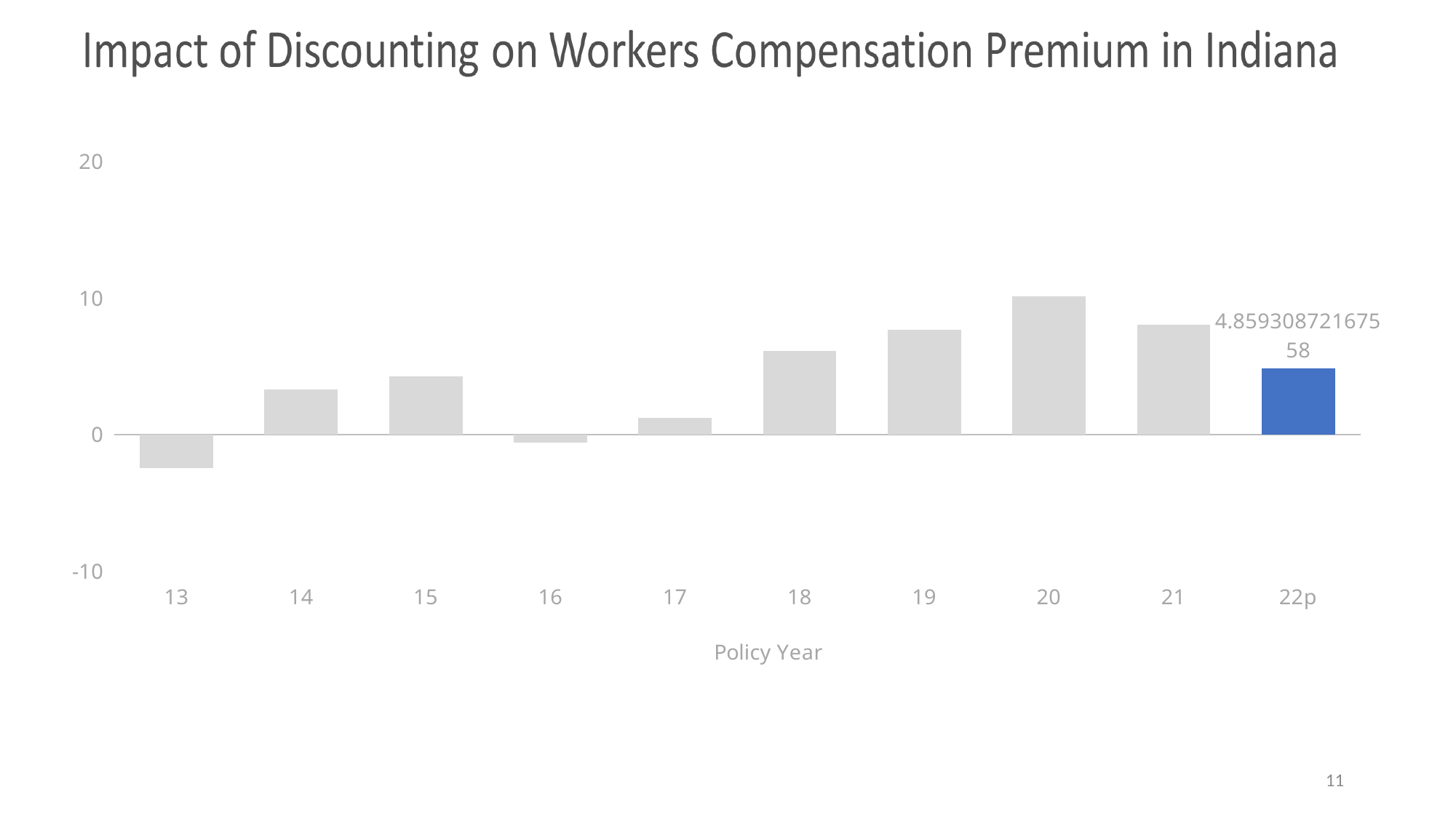
How many policy years are plotted on the chart? 10 What is the value shown for policy year 22p? 4.85930872167558 Which policy year has the highest bar? 20 What type of chart is shown on the slide? bar chart Which has the larger value, policy year 18 or policy year 19? 19 Is the value for policy year 19 greater or less than 10? less Is the value for policy year 21 greater or less than 10? less Is the value for policy year 16 greater or less than 0? less Which policy year has the lowest bar? 13 Which has the larger value, policy year 20 or policy year 21? 20 What is the title of the x axis? Policy Year